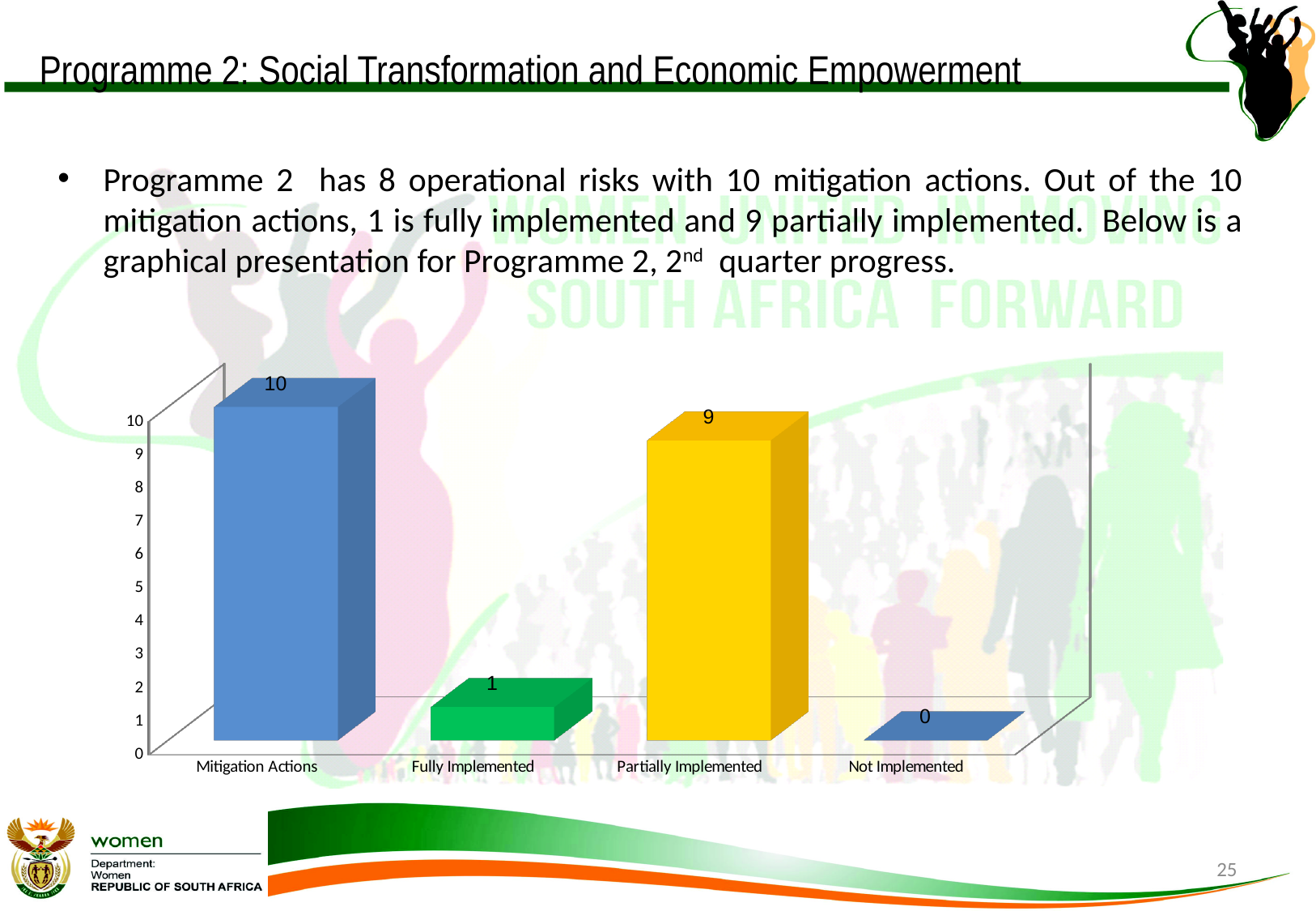
Which category has the highest value? Mitigation Actions What is the value for Not Implemented? 0 How many categories are shown on the x axis? 4 What colour is the bar for Partially Implemented? Yellow What kind of chart is shown on the slide? Bar chart What is the value for Partially Implemented? 9 What is the value for Fully Implemented? 1 What is the difference between Mitigation Actions and Partially Implemented? 1 Which category has the lowest value? Not Implemented Which is larger, Fully Implemented or Partially Implemented? Partially Implemented What is the value for Mitigation Actions? 10 What is the difference between Partially Implemented and Fully Implemented? 8